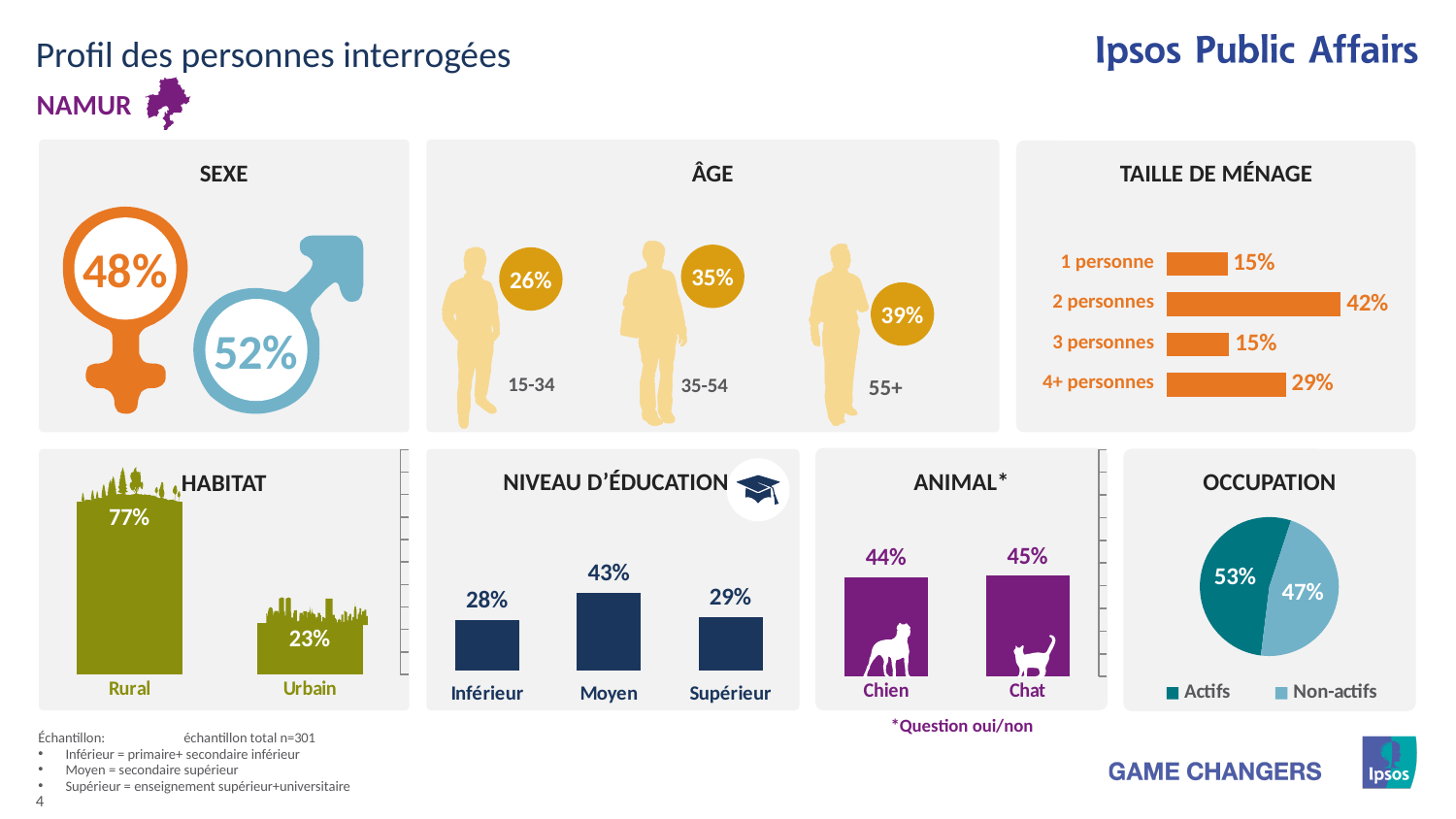
In the HABITAT chart, which category is larger, Rural or Urbain? Rural In the NIVEAU D'ÉDUCATION chart, what is the value for Inférieur? 28% In the TAILLE DE MÉNAGE chart, what is the value for 2 personnes? 42% In the NIVEAU D'ÉDUCATION chart, what is the difference between Moyen and Supérieur? 14% In the TAILLE DE MÉNAGE chart, which household size has the highest value? 2 personnes In the HABITAT chart, what is the value for Rural? 77% In the NIVEAU D'ÉDUCATION chart, which level has the highest value? Moyen In the TAILLE DE MÉNAGE chart, what is the difference between 4+ personnes and 1 personne? 14% In the ANIMAL chart, what is the value for Chat? 45% How many categories does the TAILLE DE MÉNAGE chart show? 4 What kind of chart is the OCCUPATION chart? Pie chart In the OCCUPATION chart, what share is Actifs? 53%